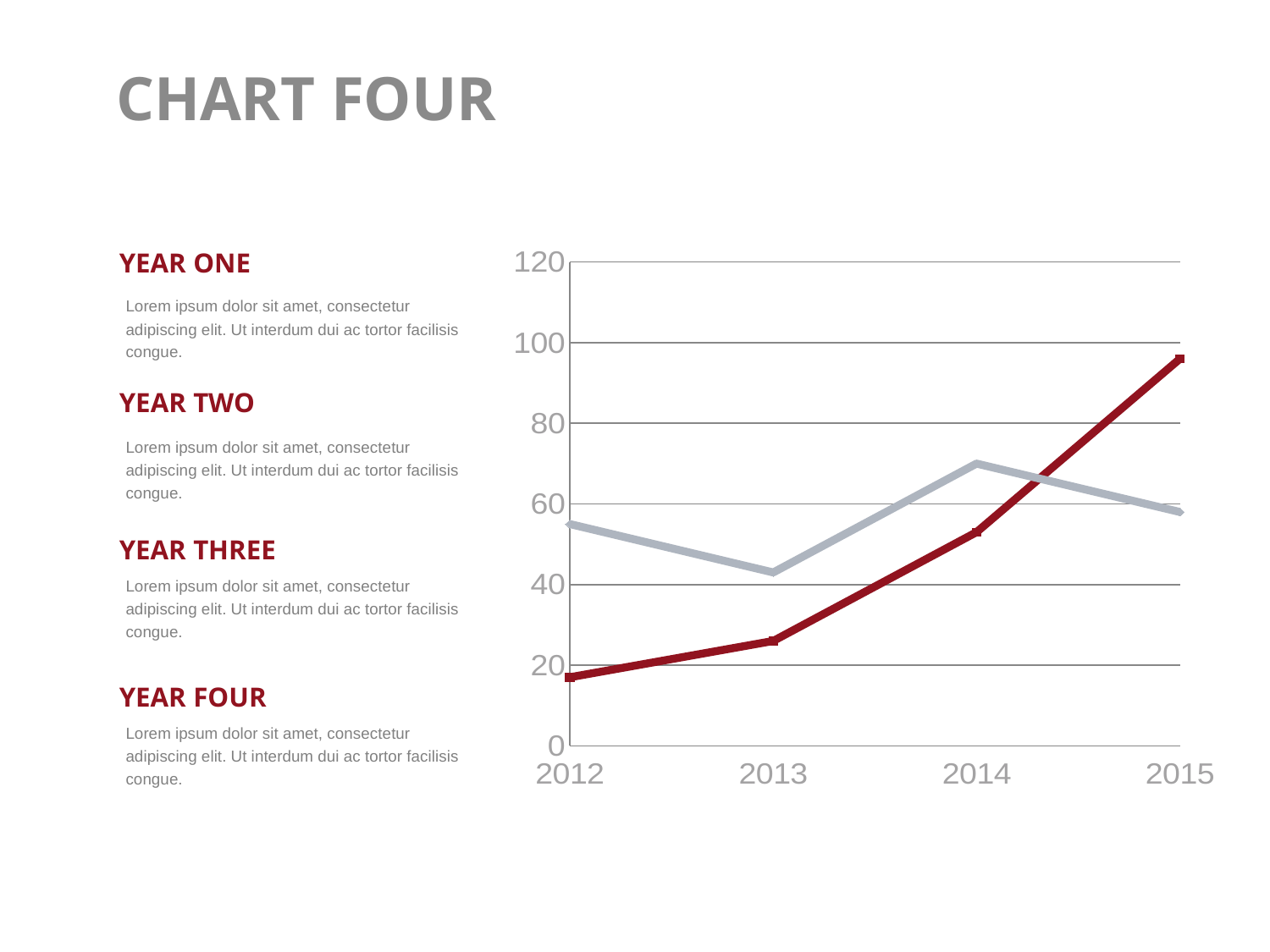
In which year does the dark red line reach its highest value? 2015 In 2012, which line has the higher value, the dark red line or the grey line? the grey line How many years are shown on the x axis of the chart? 4 Is the value of the dark red line in 2015 greater or less than 80? greater Is the value of the grey line in 2013 greater or less than 60? less What kind of chart is shown on the slide? line chart Is the value of the grey line in 2014 greater or less than 60? greater How many lines are plotted on the chart? 2 In 2015, which line has the higher value, the dark red line or the grey line? the dark red line Does the dark red line rise or fall from 2012 to 2015? rise In which year does the grey line reach its lowest value? 2013